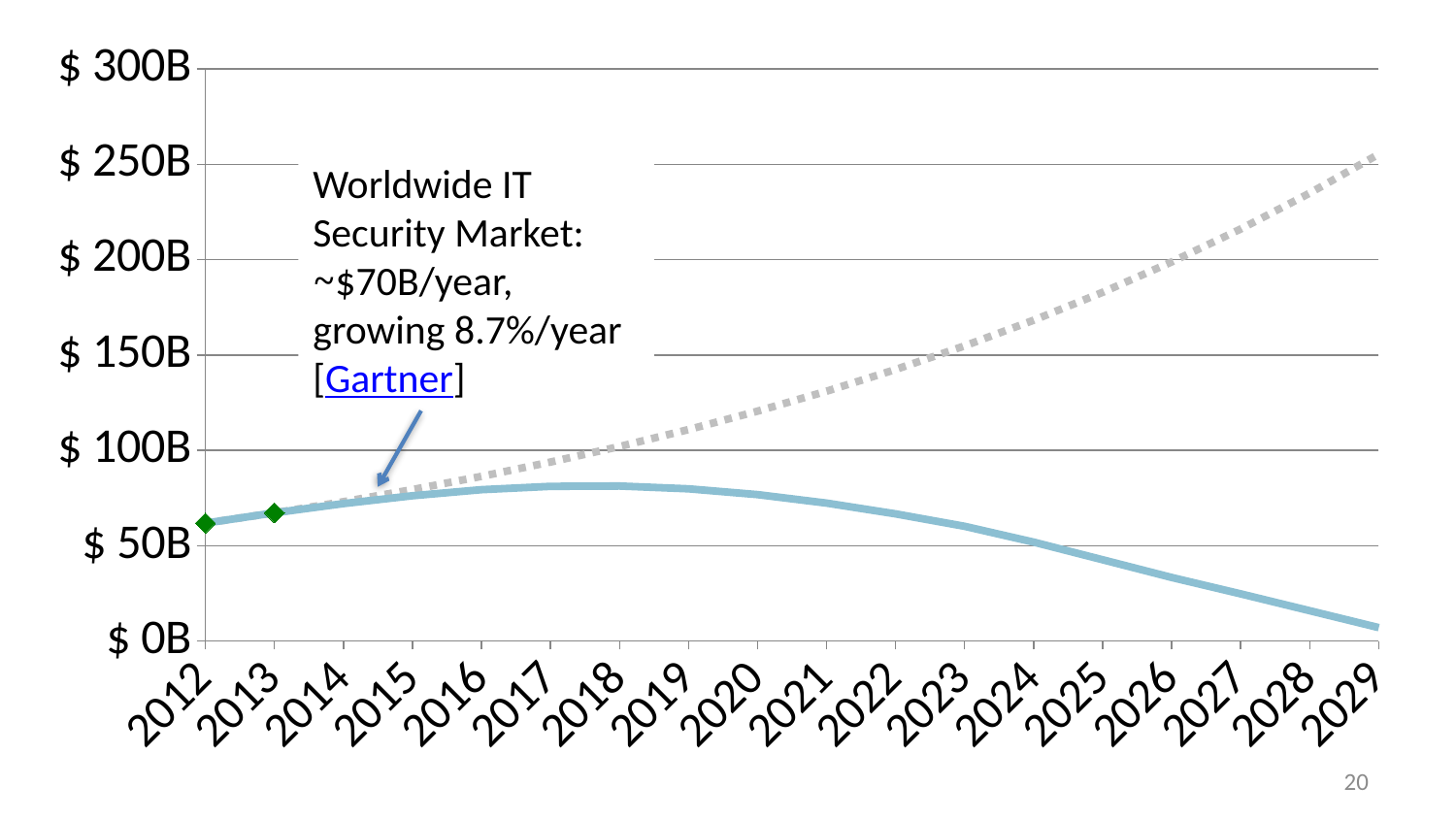
Does the dotted grey line rise or fall from 2012 to 2029? rise Does the solid blue line rise or fall between 2018 and 2029? fall How many years are labelled along the x axis? 18 Is the value of the dotted grey line in 2023 greater or less than $100B? greater What is the last year shown on the x axis? 2029 In 2029, which line has the larger value, the dotted grey line or the solid blue line? the dotted grey line Is the value of the dotted grey line in 2029 greater or less than $200B? greater Is the value of the solid blue line in 2018 greater or less than $100B? less What kind of chart is shown on the slide? line chart What is the first year shown on the x axis? 2012